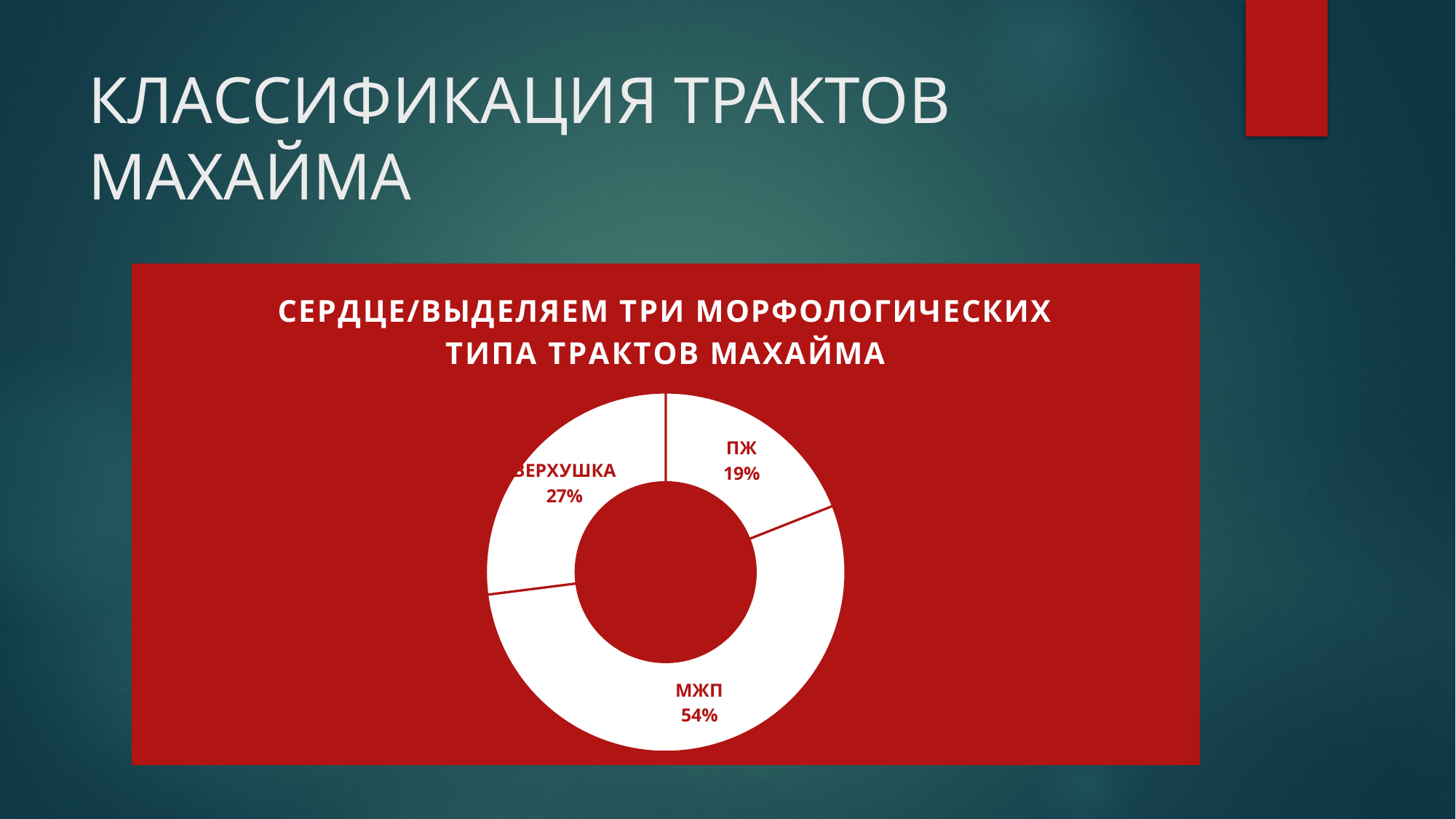
Which category has the smallest share of the chart? ПЖ What share of the chart does ПЖ account for? 19% What is the combined share of ПЖ and ВЕРХУШКА? 46% Which has a larger share, ВЕРХУШКА or ПЖ? ВЕРХУШКА What kind of chart is shown on the slide? Pie chart (doughnut) What share of the chart does МЖП account for? 54% What share of the chart does ВЕРХУШКА account for? 27% What is the title of the chart? СЕРДЦЕ/ВЫДЕЛЯЕМ ТРИ МОРФОЛОГИЧЕСКИХ ТИПА ТРАКТОВ МАХАЙМА What is the difference in percentage points between the shares of ВЕРХУШКА and ПЖ? 8% What is the difference in percentage points between the shares of МЖП and ВЕРХУШКА? 27% Which category has the largest share of the chart? МЖП How many categories are shown in the chart? 3